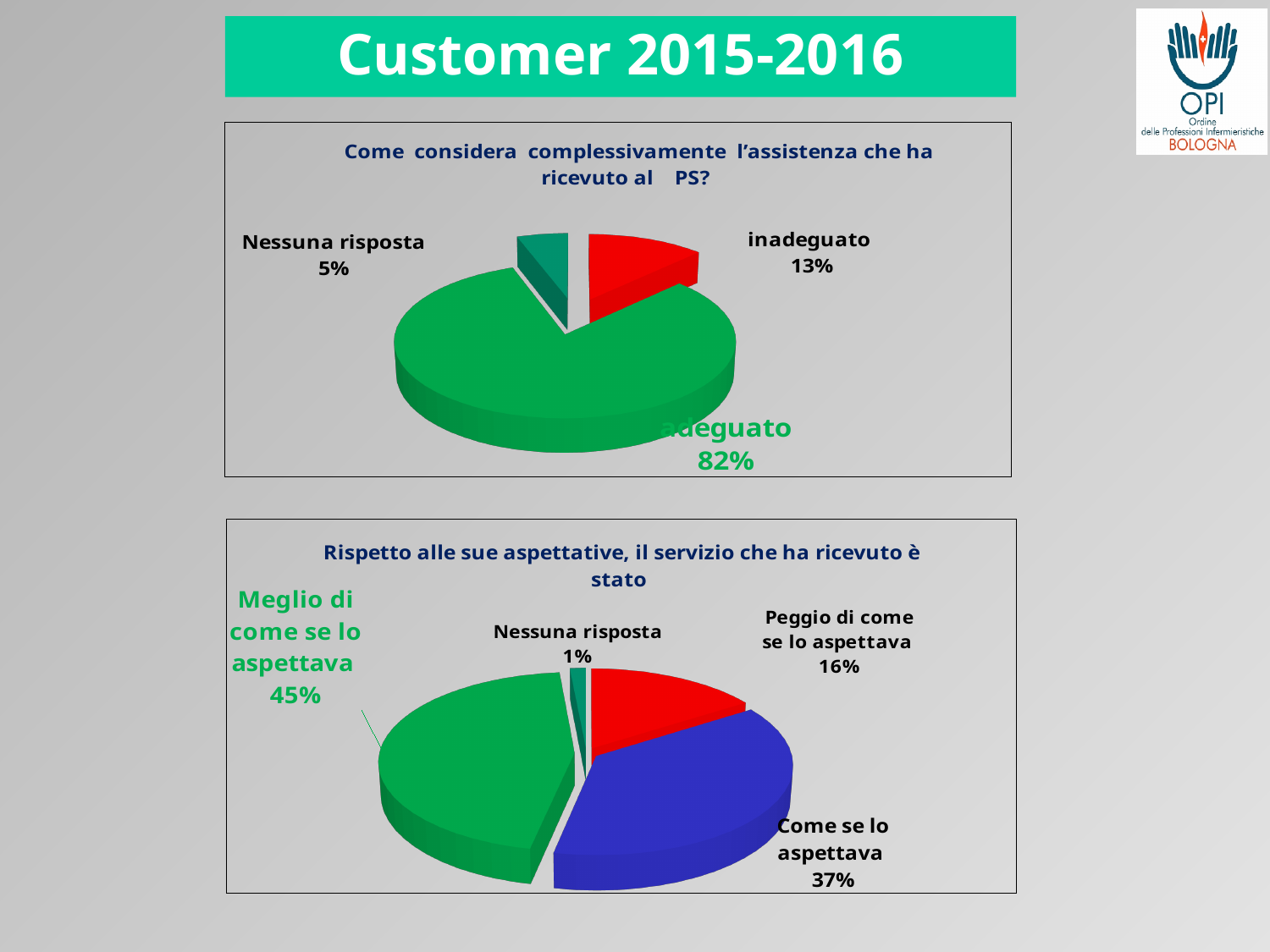
How many slices does the bottom chart have? 4 In the top chart, what percentage of respondents answered "inadeguato"? 13% In the bottom chart, which category has the smallest slice? Nessuna risposta In the top chart, which category has the smallest slice? Nessuna risposta In the bottom chart, what percentage answered "Come se lo aspettava"? 37% What kind of chart is the top chart? Pie chart In the bottom chart ("Rispetto alle sue aspettative, il servizio che ha ricevuto è stato"), what percentage answered "Meglio di come se lo aspettava"? 45% In the top chart, what is the difference in percentage points between "adeguato" and "inadeguato"? 69 In the top chart ("Come considera complessivamente l'assistenza che ha ricevuto al PS?"), what percentage of respondents answered "adeguato"? 82% In the top chart, which category has the largest slice? adeguato In the top chart, what share is labelled "Nessuna risposta"? 5% In the bottom chart, what percentage answered "Peggio di come se lo aspettava"? 16%